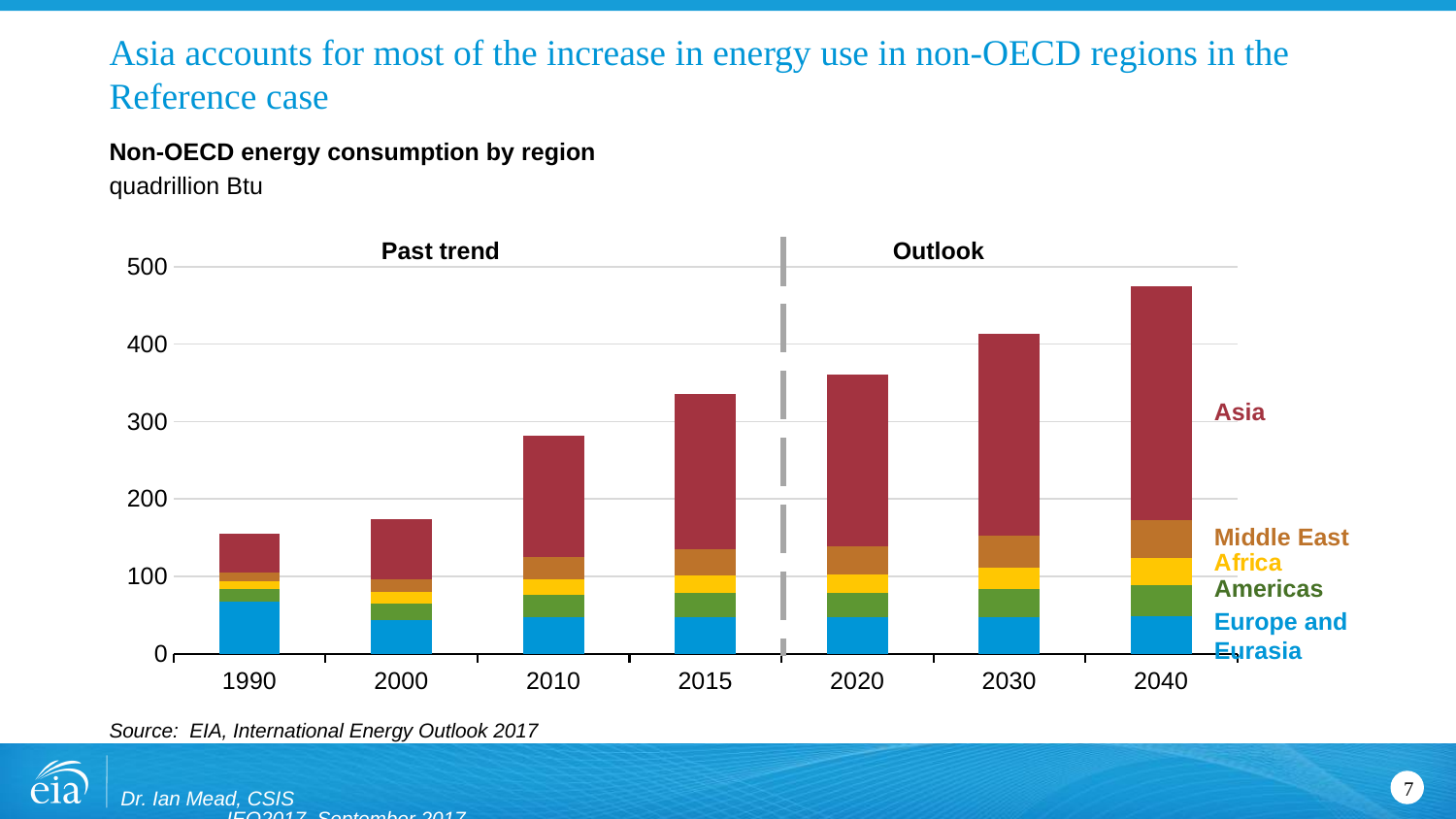
How many years (categories) are shown on the x axis of the chart? 7 Which year has the lowest total non-OECD energy consumption? 1990 What kind of chart is shown on the slide? stacked bar chart Is the total value for 2020 greater or less than 300? greater Which region accounts for the largest segment of the 2040 bar? Asia Is the total value for 2010 greater or less than 300? less What unit is the chart's y axis measured in? quadrillion Btu Is the total value for 1990 greater or less than 200? less Which year has the highest total non-OECD energy consumption? 2040 How many regions (series) are labelled on the chart? 5 Do total non-OECD energy consumption values rise or fall from 1990 to 2040? rise